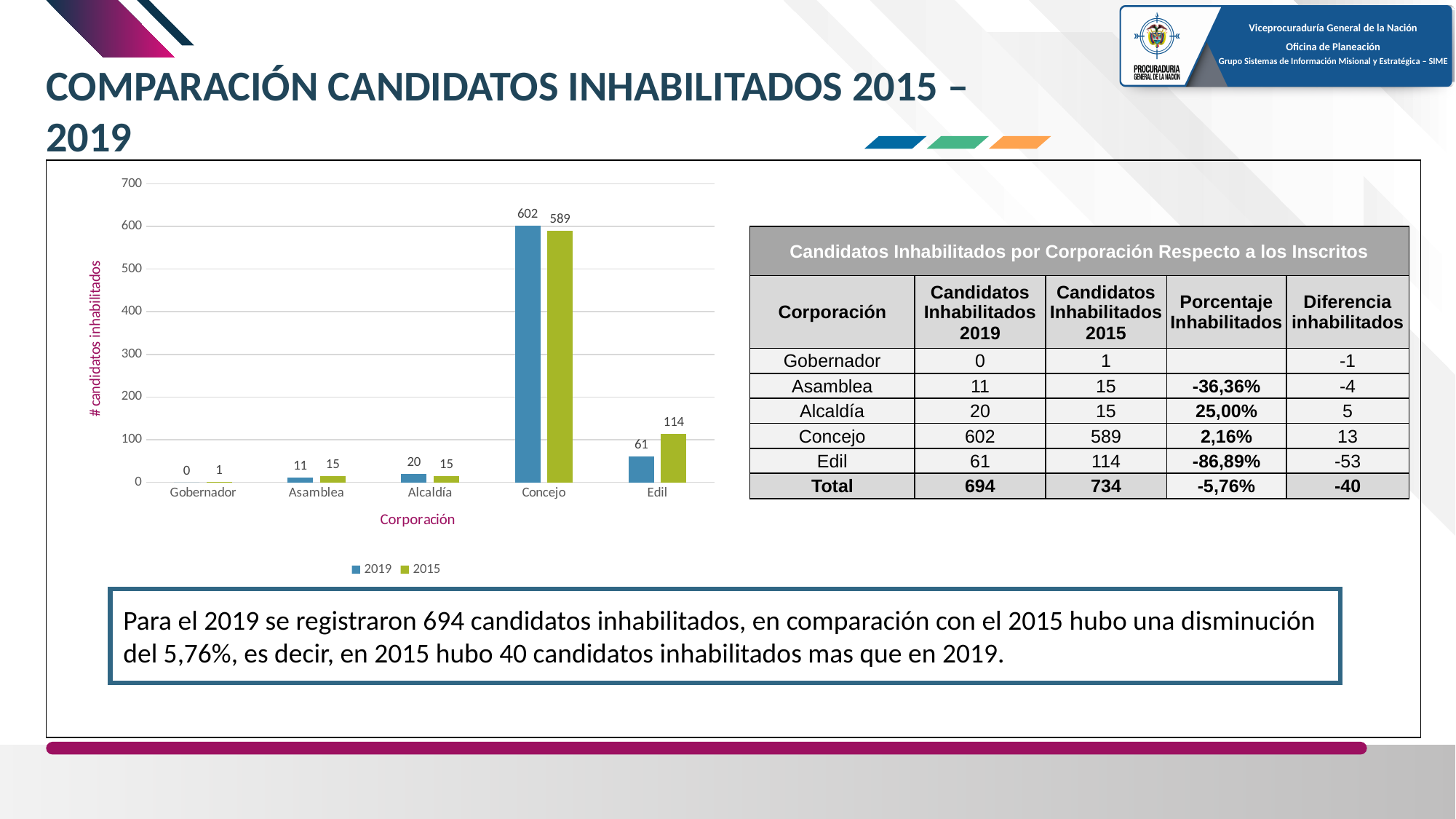
What is the value for Concejo in the 2019 series? 602 Which category has the lowest value in the 2019 series? Gobernador What is the value for Edil in the 2015 series? 114 Which category has the highest value in the 2015 series? Concejo How many series does the legend list? 2 How many categories are shown on the x axis? 5 What is the value for Alcaldía in the 2019 series? 20 Is the value for Concejo in 2019 greater or less than 500? greater What is the difference between the 2015 and 2019 values for Edil? 53 Which is larger for Asamblea, the 2019 value or the 2015 value? 2015 What kind of chart is shown on the slide? bar chart What is the label of the y axis? # candidatos inhabilitados